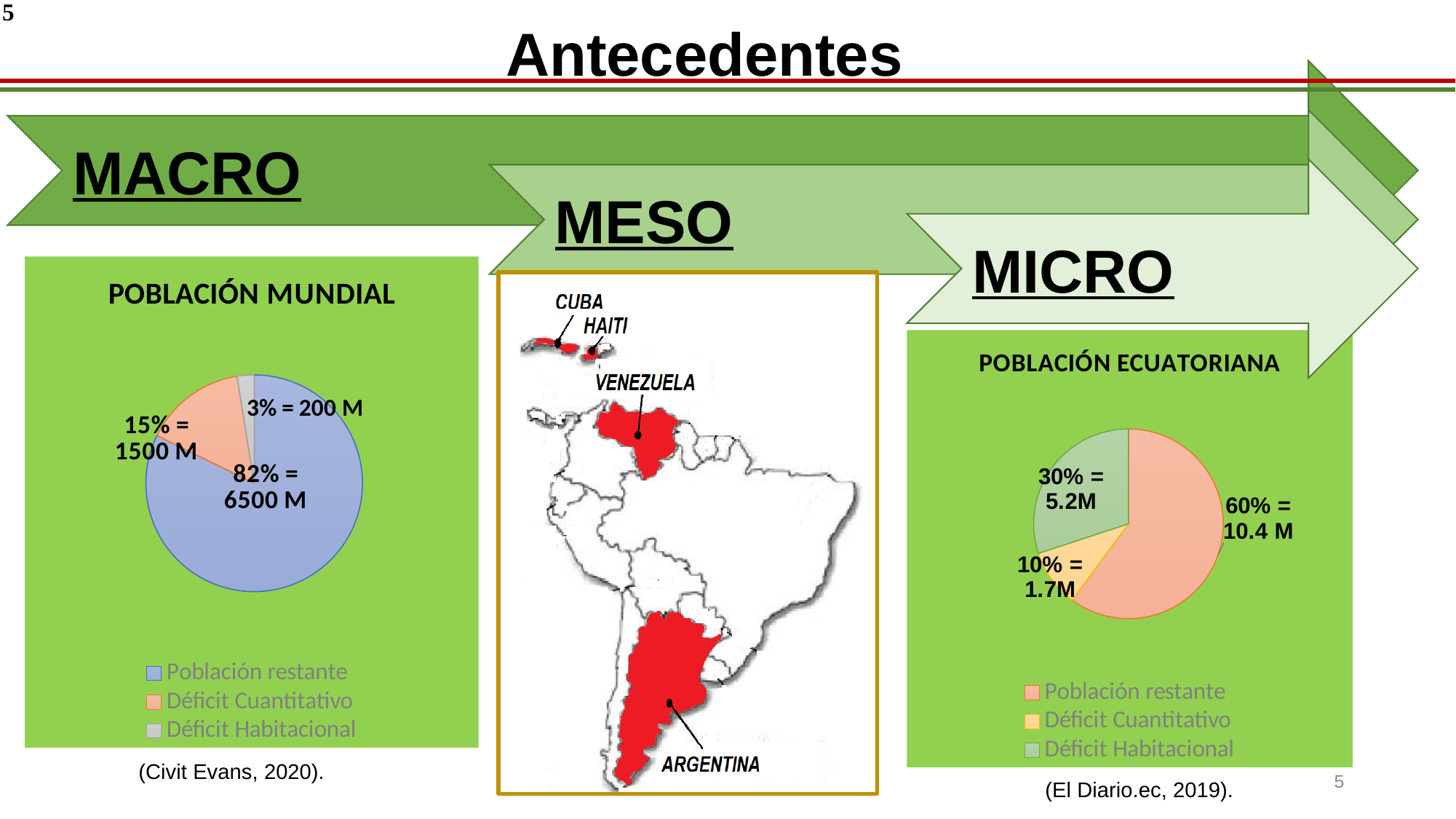
In the POBLACIÓN MUNDIAL chart, what share of the pie is Población restante? 82% In the POBLACIÓN MUNDIAL chart, which slice is the smallest? Déficit Habitacional In the POBLACIÓN MUNDIAL chart, how many entries does the legend list? 3 In the POBLACIÓN ECUATORIANA chart, what value is shown for Déficit Cuantitativo? 1.7M In the POBLACIÓN MUNDIAL chart, what value is shown for Déficit Cuantitativo? 1500 M In the POBLACIÓN MUNDIAL chart, how many slices does the pie have? 3 In the POBLACIÓN ECUATORIANA chart, what share of the pie is Déficit Habitacional? 30% In the POBLACIÓN ECUATORIANA chart, which is larger, Déficit Habitacional or Déficit Cuantitativo? Déficit Habitacional What kind of chart is the POBLACIÓN ECUATORIANA chart? Pie chart In the POBLACIÓN MUNDIAL chart, what value is shown for Déficit Habitacional? 200 M In the POBLACIÓN ECUATORIANA chart, which slice is the largest? Población restante In the POBLACIÓN ECUATORIANA chart, what value is shown for Población restante? 10.4 M